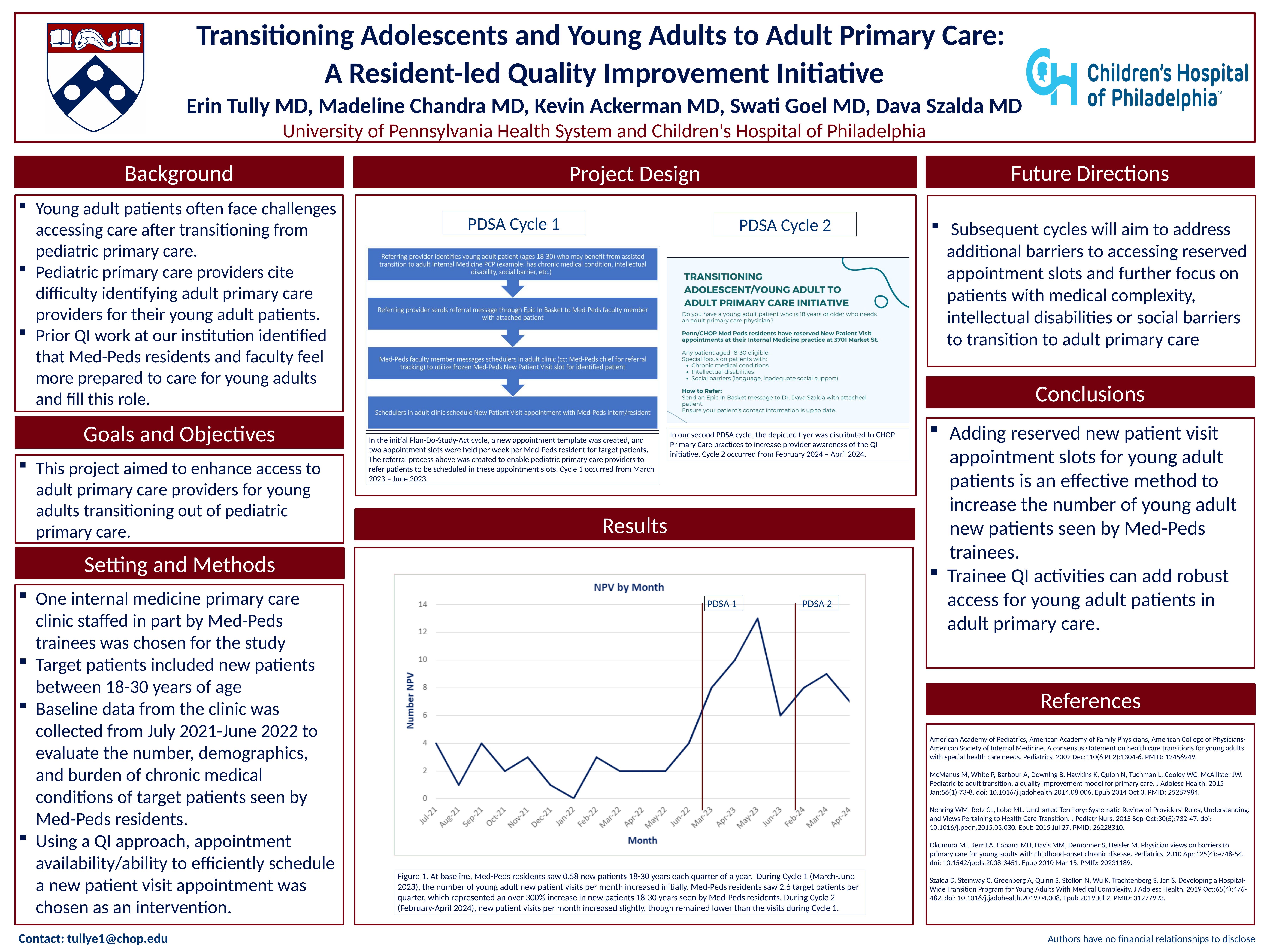
What is the Number NPV for Jun-23 in the "NPV by Month" chart? 6 Which month has the lowest value in the "NPV by Month" chart? Jan-22 Is the value for Aug-21 in the "NPV by Month" chart greater or less than 2? less Is the value for May-23 in the "NPV by Month" chart greater or less than 12? greater In the "NPV by Month" chart, do the values rise or fall from Mar-23 to May-23? rise How many months are plotted on the x axis of the "NPV by Month" chart? 19 Which month has the highest value in the "NPV by Month" chart? May-23 What is the Number NPV for Apr-23 in the "NPV by Month" chart? 10 What is the title of the chart in the Results section? NPV by Month What is the Number NPV for Jan-22 in the "NPV by Month" chart? 0 In the "NPV by Month" chart, which is larger, the value for May-23 or the value for Mar-24? May-23 What kind of chart is the "NPV by Month" chart? line chart